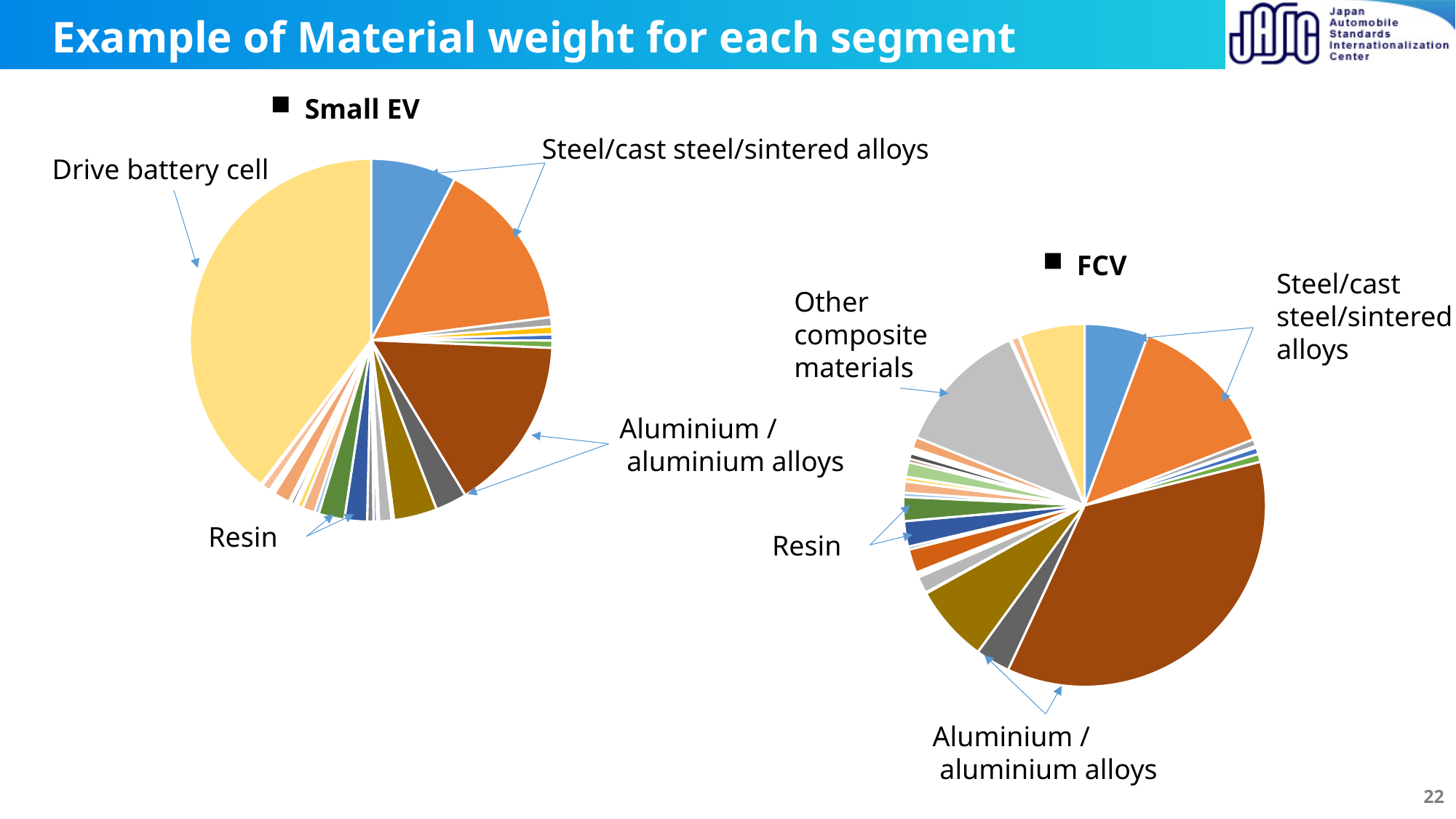
In the FCV chart, which slice is larger: Other composite materials or Resin? Other composite materials In the Small EV chart, which slice is larger: Aluminium / aluminium alloys or Resin? Aluminium / aluminium alloys What is the title of the slide? Example of Material weight for each segment What kind of chart is the FCV chart? Pie chart In the Small EV chart, which labelled material has the largest slice? Drive battery cell Which two vehicle segments are shown in the charts? Small EV and FCV What kind of chart is the Small EV chart? Pie chart In the FCV chart, which labelled material has the largest slice? Aluminium / aluminium alloys How many pie charts are shown on the slide? 2 In the Small EV chart, which slice is larger: Steel/cast steel/sintered alloys or Resin? Steel/cast steel/sintered alloys